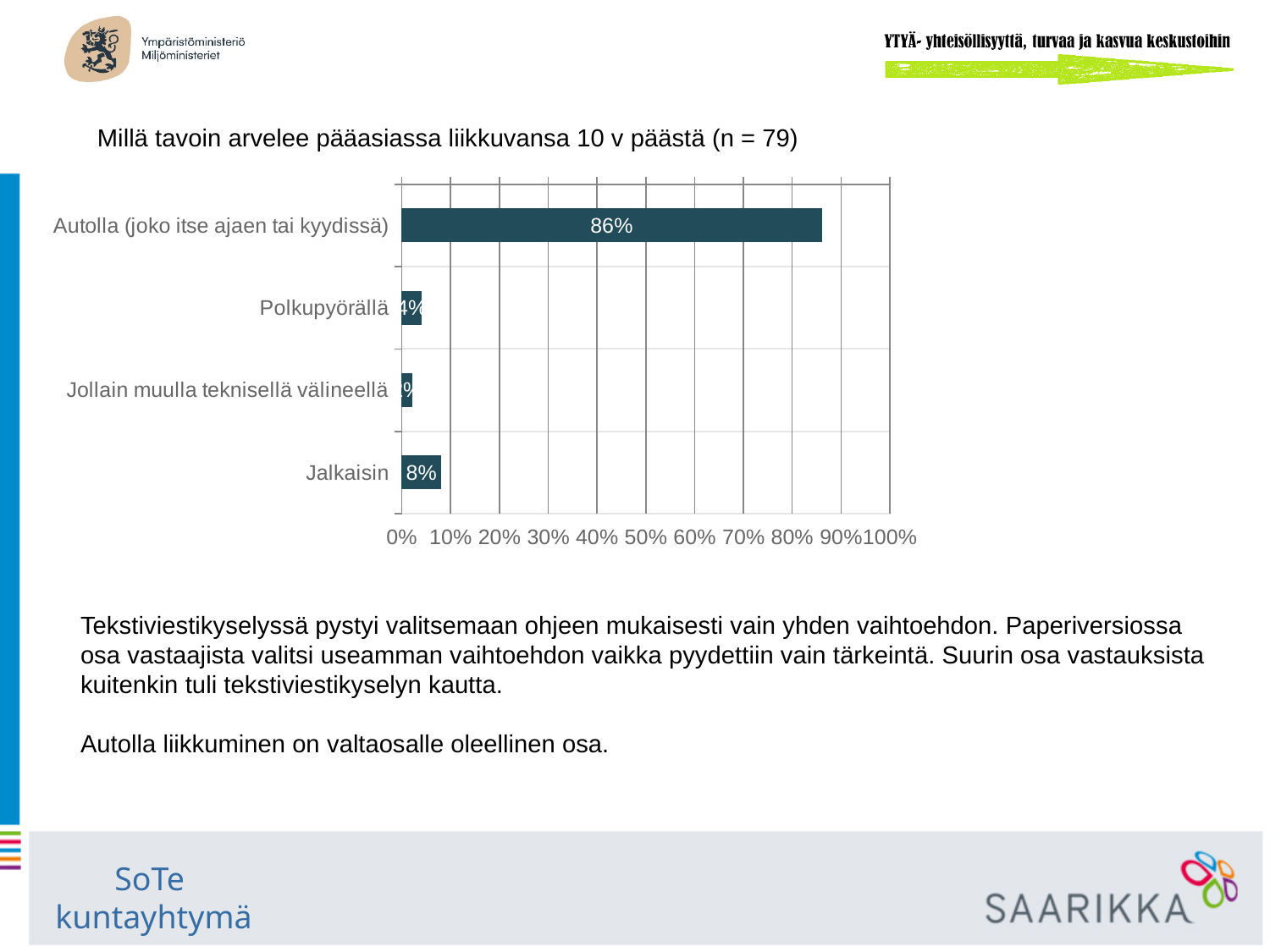
What kind of chart is shown on the slide? Bar chart Is the value for Autolla (joko itse ajaen tai kyydissä) greater or less than 80%? greater What is the title of the chart? Millä tavoin arvelee pääasiassa liikkuvansa 10 v päästä (n = 79) How many categories are shown in the chart? 4 Is the value for Jollain muulla teknisellä välineellä greater or less than 10%? less Which category has the highest value? Autolla (joko itse ajaen tai kyydissä) What is the difference between the values for Jalkaisin and Polkupyörällä? 4% What is the value for Polkupyörällä? 4% What is the value for Autolla (joko itse ajaen tai kyydissä)? 86% Which is larger, the value for Jalkaisin or the value for Polkupyörällä? Jalkaisin What is the difference between the values for Autolla (joko itse ajaen tai kyydissä) and Jalkaisin? 78% What is the value for Jalkaisin? 8%